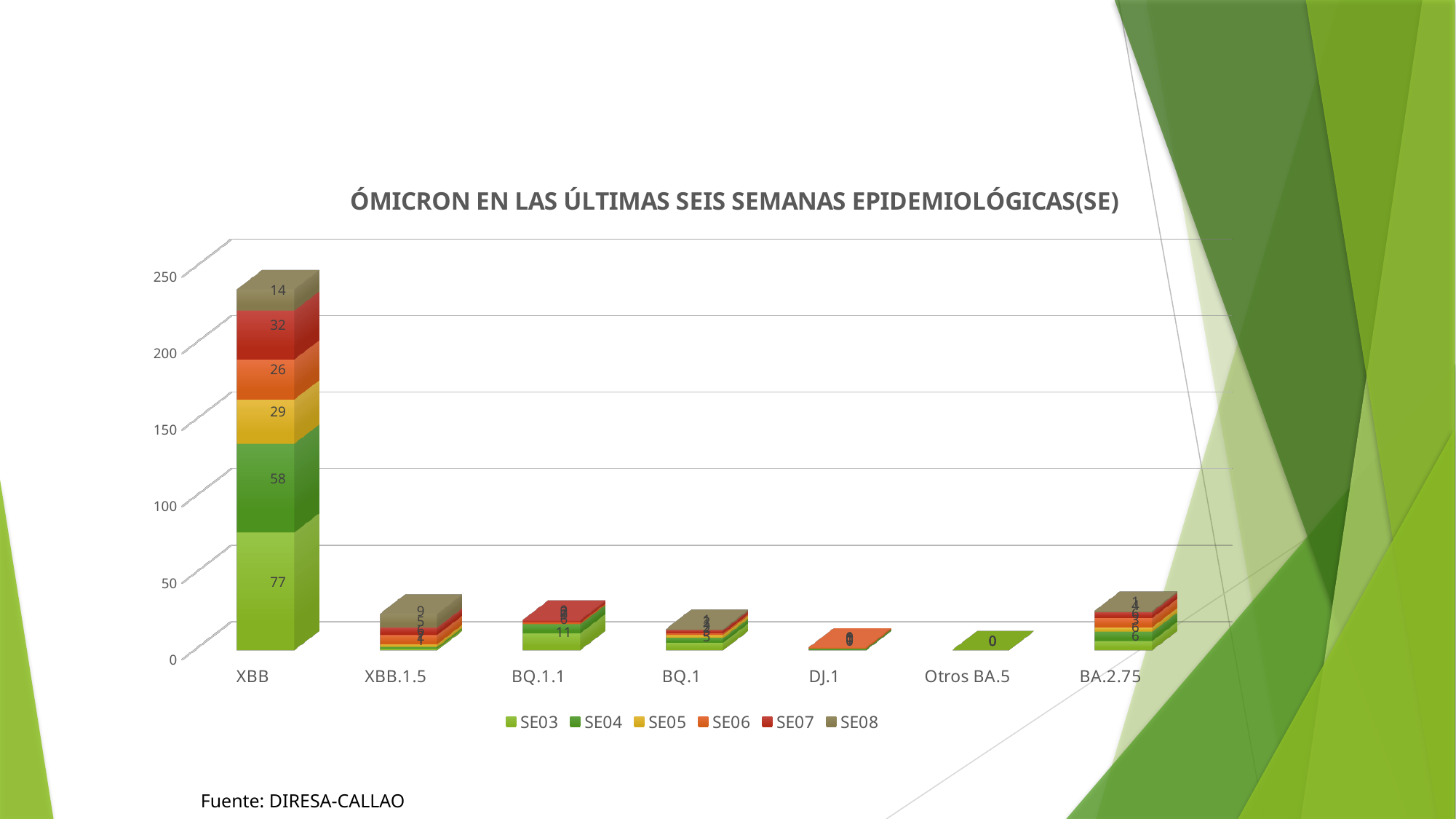
What is the SE03 value for XBB? 77 What is the total of the stacked bar for XBB? 236 What is the SE08 value for XBB? 14 What kind of chart is shown on the slide? Stacked bar chart How many series does the legend list? 6 For XBB, which is larger: the SE05 value or the SE06 value? SE05 Is the total stacked bar for XBB greater or less than 200? greater What is the difference between the SE03 and SE04 values for XBB? 19 How many variant categories are shown on the x axis? 7 Which variant has the highest total stacked bar? XBB What is the SE07 value for XBB? 32 What is the SE04 value for XBB? 58